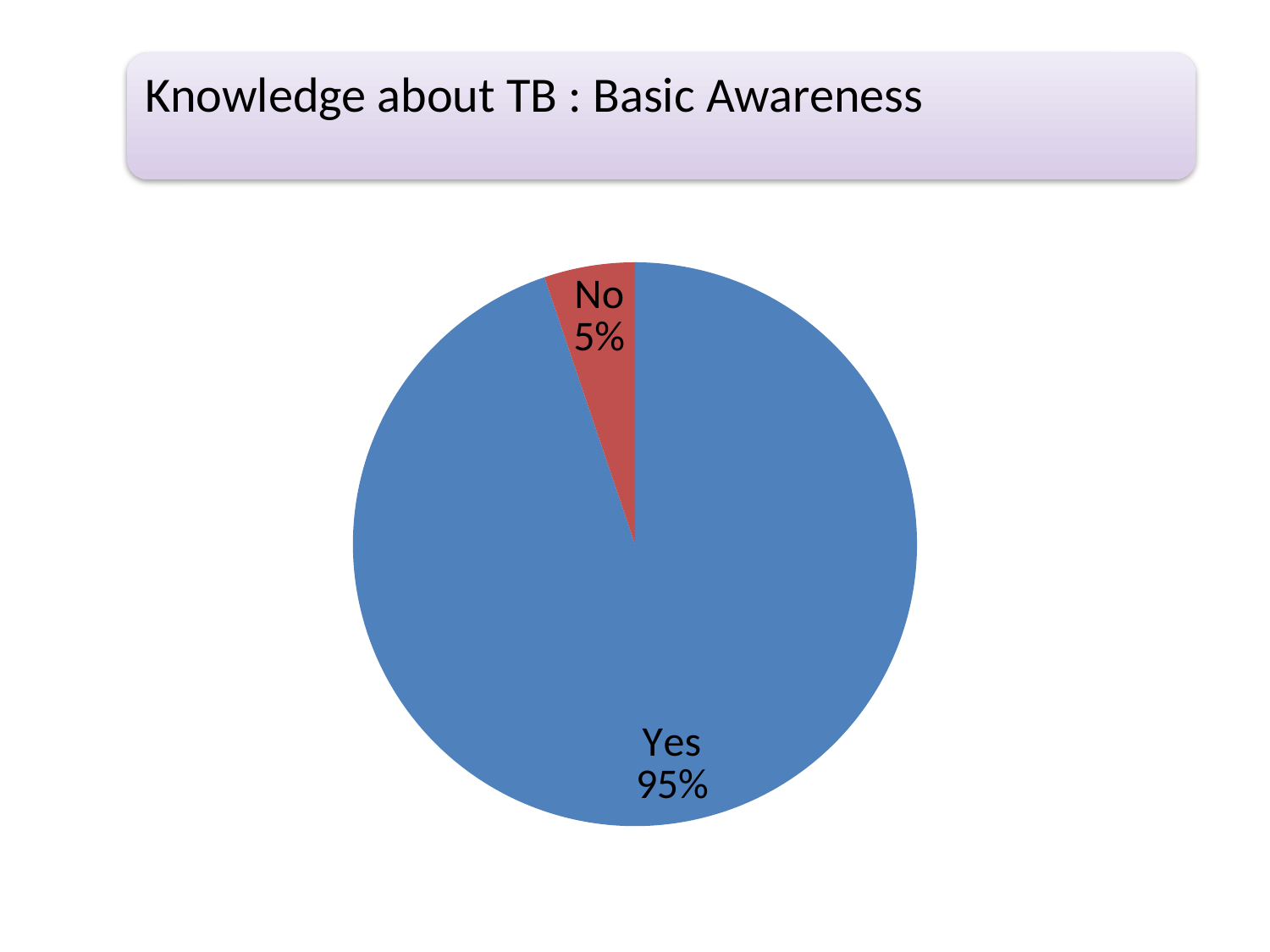
Which slice of the pie is the largest? Yes What kind of chart is shown on the slide? pie chart How many slices does the pie chart have? 2 What is the difference in percentage points between the "Yes" and "No" slices? 90 What percentage of the pie is labelled "No"? 5% Which is larger, the "Yes" slice or the "No" slice? Yes What colour is the "No" slice of the pie? red What percentage of the pie is labelled "Yes"? 95% What is the title of the slide containing the pie chart? Knowledge about TB : Basic Awareness What share of the pie does the "No" slice represent? 5% Which slice of the pie is the smallest? No